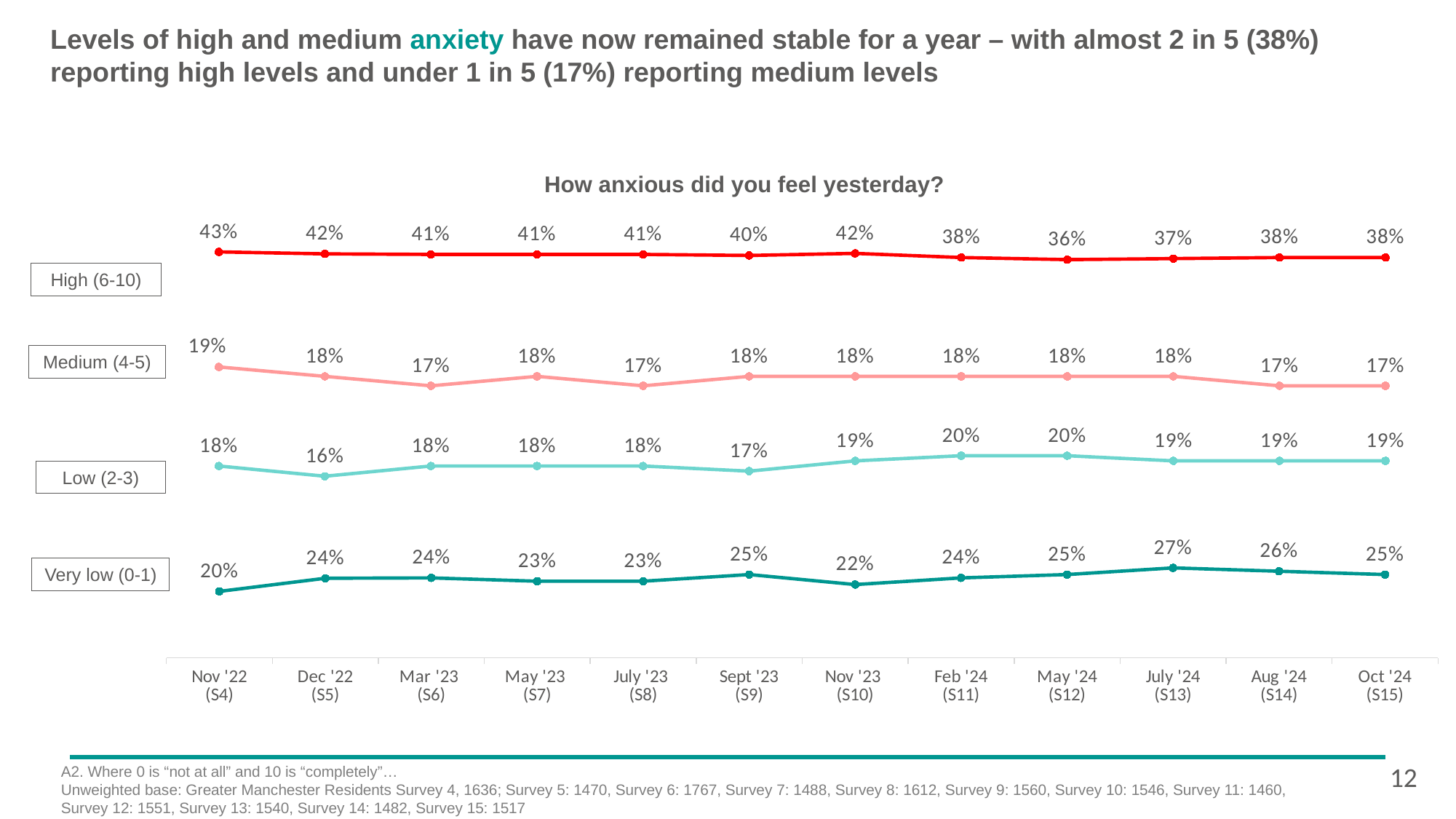
How many series are plotted on the chart? 4 What is the value for Low (2-3) in Dec '22 (S5)? 16% What is the value for Medium (4-5) in Nov '22 (S4)? 19% What is the value for Very low (0-1) in Nov '22 (S4)? 20% How many survey waves are shown on the x axis? 12 What is the title of the chart? How anxious did you feel yesterday? What is the value for High (6-10) in Oct '24 (S15)? 38% In which survey wave is the Very low (0-1) value highest? July '24 (S13) What is the difference between the High (6-10) value in Nov '22 (S4) and in Oct '24 (S15)? 5 percentage points In which survey wave is the High (6-10) value lowest? May '24 (S12) What type of chart is shown? Line chart Which is larger in Oct '24 (S15): the Very low (0-1) value or the Low (2-3) value? Very low (0-1)